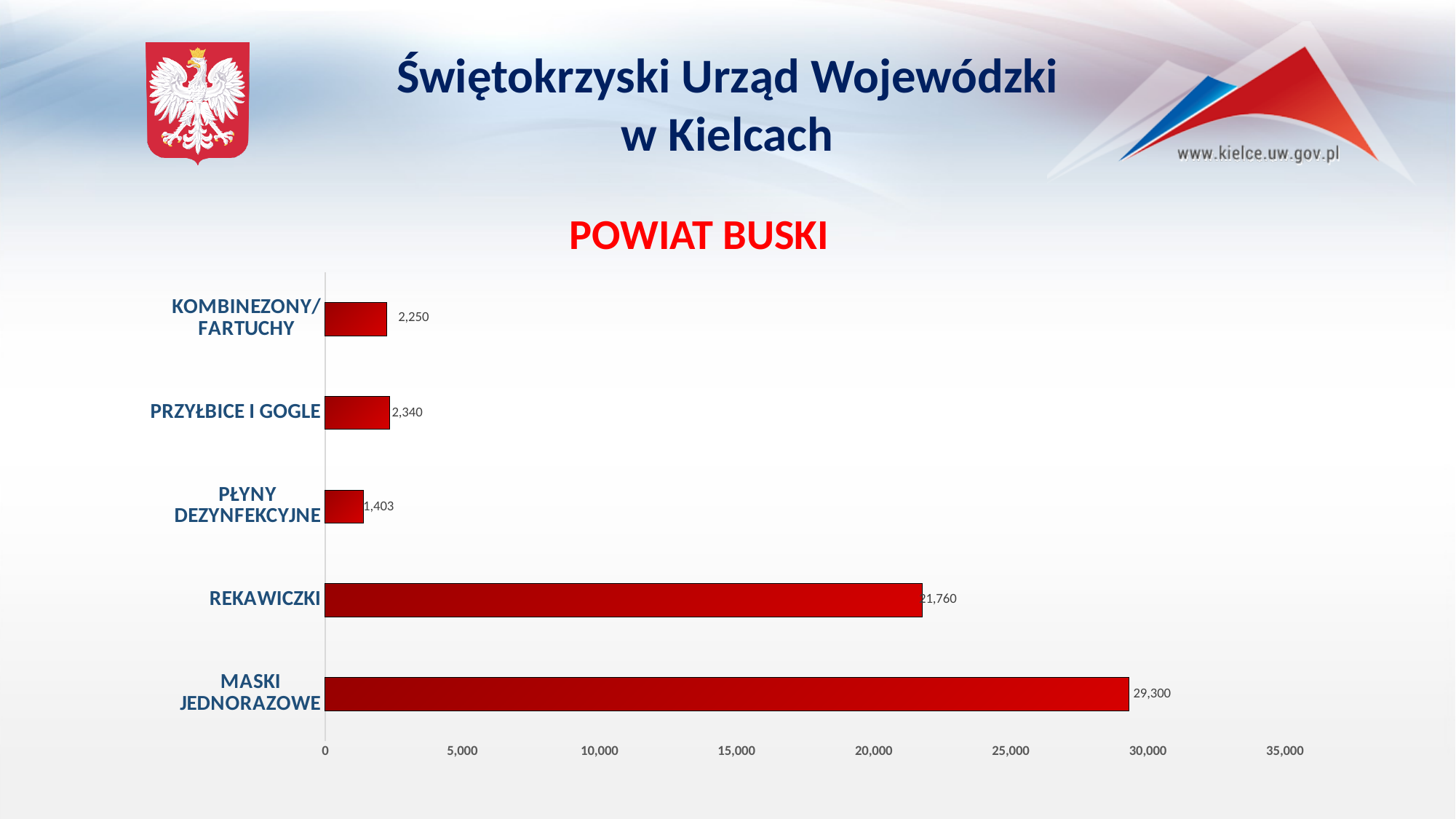
What is the value for PRZYŁBICE I GOGLE? 2,340 What is the difference between the values for MASKI JEDNORAZOWE and REKAWICZKI? 7,540 Which category has the lowest value? PŁYNY DEZYNFEKCYJNE What is the value for REKAWICZKI? 21,760 Which category has the highest value? MASKI JEDNORAZOWE What is the value for KOMBINEZONY/FARTUCHY? 2,250 Is the value for REKAWICZKI greater or less than 20,000? greater How many categories are shown in the chart? 5 Which is larger, the value for PRZYŁBICE I GOGLE or the value for KOMBINEZONY/FARTUCHY? PRZYŁBICE I GOGLE What is the value for MASKI JEDNORAZOWE? 29,300 What kind of chart is shown on the slide? bar chart What is the value for PŁYNY DEZYNFEKCYJNE? 1,403